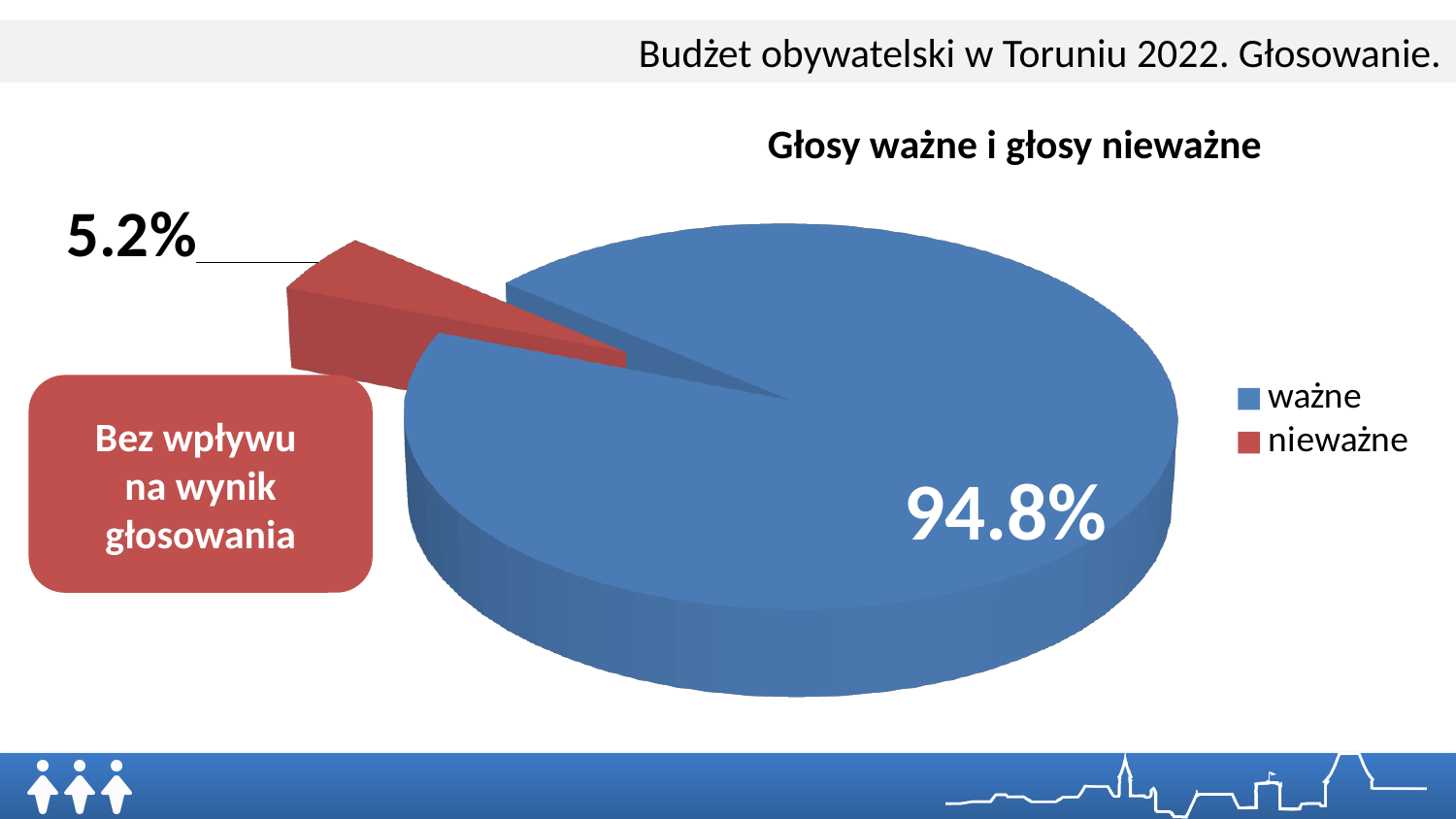
How many entries does the legend list? 2 Which category has the smallest slice of the pie? nieważne What share of the pie is labelled 'nieważne'? 5.2% What kind of chart is shown on the slide? pie chart What share of the pie is labelled 'ważne'? 94.8% Which is larger, the share for 'ważne' or the share for 'nieważne'? ważne Which category has the largest slice of the pie? ważne How many slices does the pie chart have? 2 What colour is the 'nieważne' slice? red What is the chart's title? Głosy ważne i głosy nieważne What is the difference in percentage points between the 'ważne' and 'nieważne' shares? 89.6